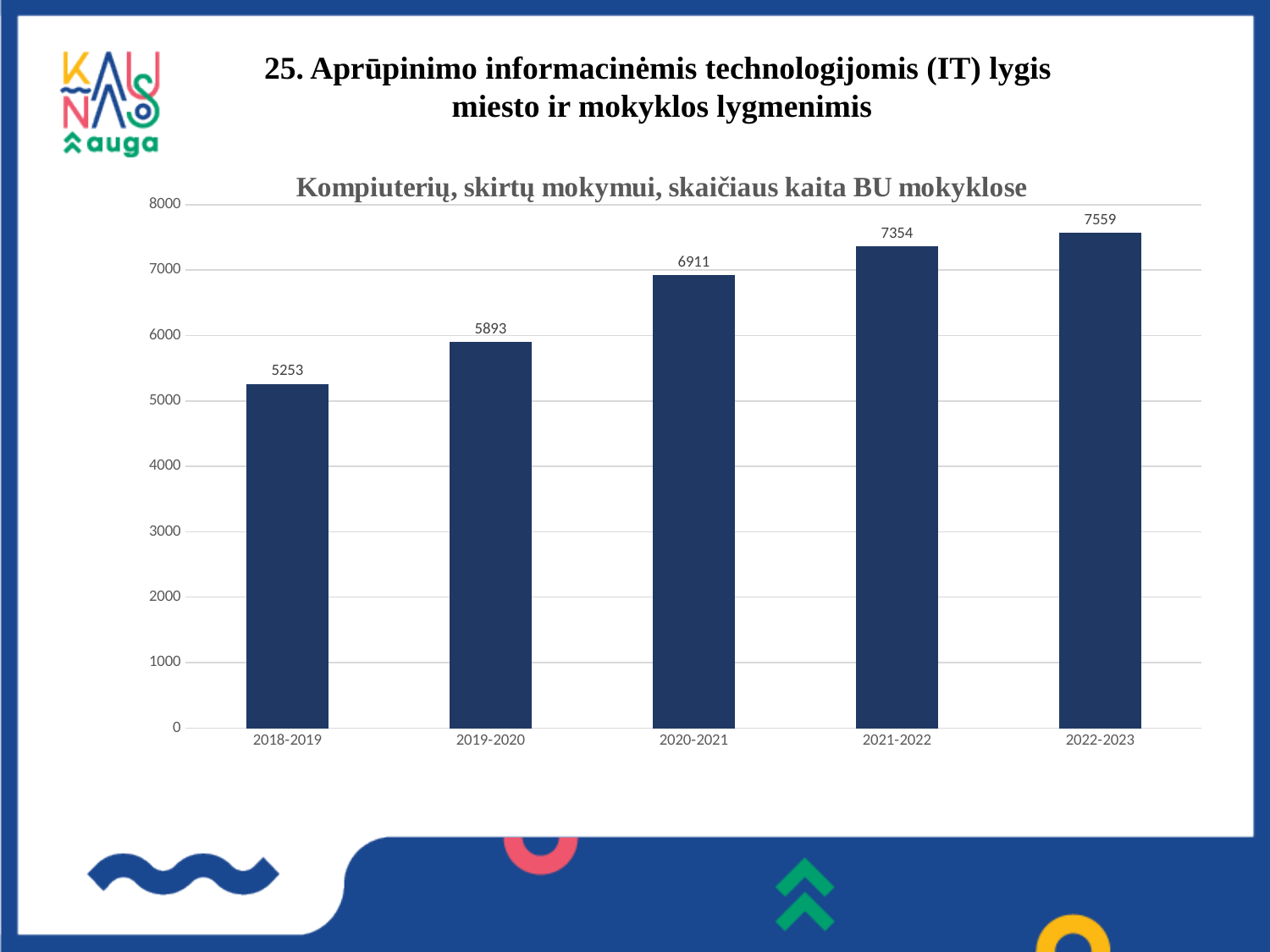
What is the value for 2020-2021? 6911 What kind of chart is shown on the slide? bar chart Which school year has the lowest value? 2018-2019 Do the values rise or fall from 2018-2019 to 2022-2023? rise Which school year has the highest value? 2022-2023 Is the value for 2019-2020 greater or less than 6000? less What is the value for 2018-2019? 5253 What is the difference between the values for 2022-2023 and 2018-2019? 2306 How many school years are shown on the x axis? 5 What is the difference between the values for 2019-2020 and 2018-2019? 640 What is the value for 2022-2023? 7559 Which is larger, the value for 2019-2020 or the value for 2021-2022? 2021-2022